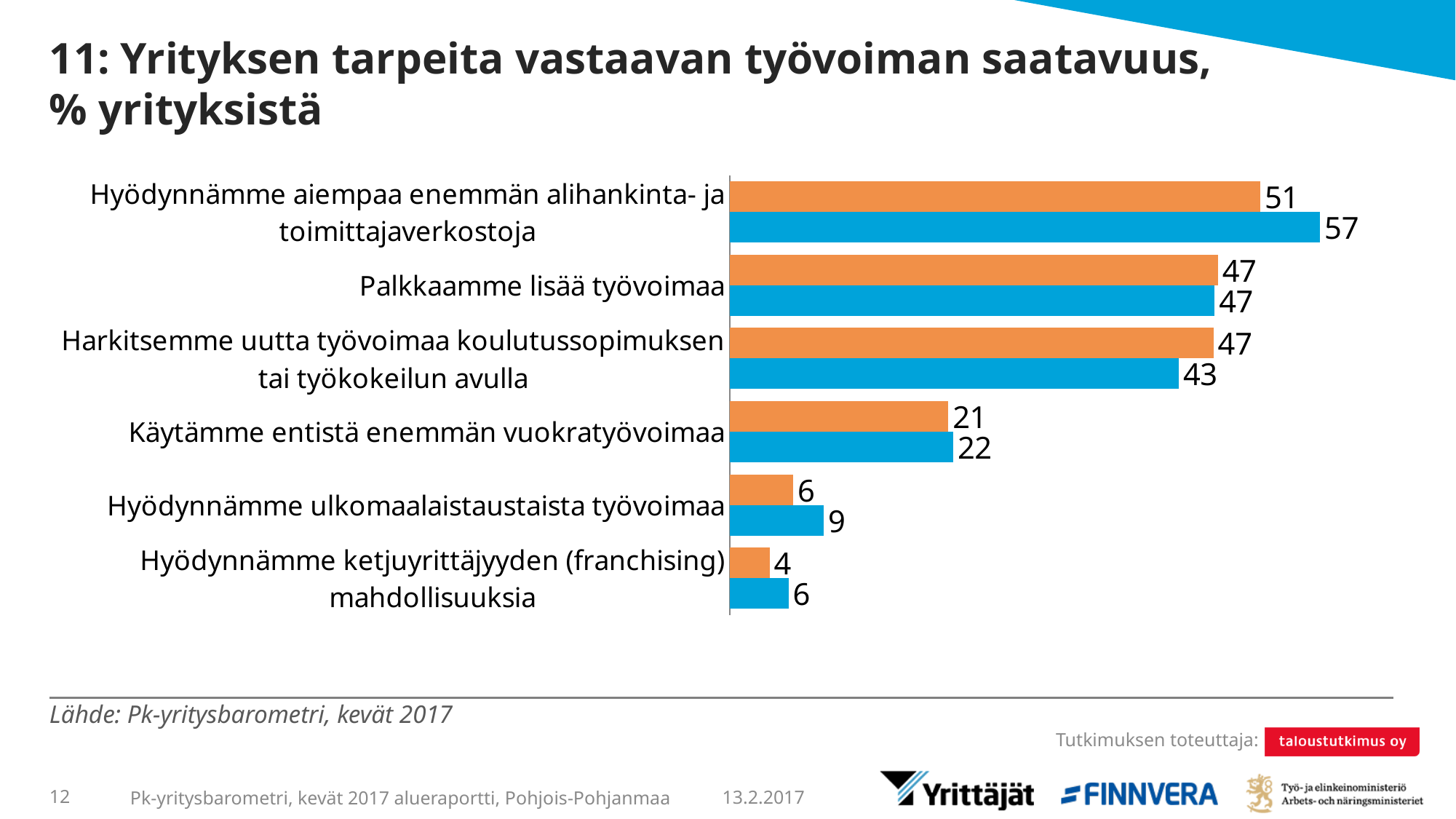
How many categories are shown in the chart? 6 Which category has the highest blue bar value? Hyödynnämme aiempaa enemmän alihankinta- ja toimittajaverkostoja What is the value of the blue bar for "Hyödynnämme ulkomaalaistaustaista työvoimaa"? 9 What is the value of the orange bar for "Palkkaamme lisää työvoimaa"? 47 What is the difference between the blue and orange bar values for "Hyödynnämme aiempaa enemmän alihankinta- ja toimittajaverkostoja"? 6 What is the value of the blue bar for "Hyödynnämme aiempaa enemmän alihankinta- ja toimittajaverkostoja"? 57 What is the source cited below the chart? Pk-yritysbarometri, kevät 2017 Which category has the lowest orange bar value? Hyödynnämme ketjuyrittäjyyden (franchising) mahdollisuuksia What is the difference between the orange and blue bar values for "Harkitsemme uutta työvoimaa koulutussopimuksen tai työkokeilun avulla"? 4 What type of chart is shown on the slide? bar chart What is the value of the orange bar for "Käytämme entistä enemmän vuokratyövoimaa"? 21 For "Hyödynnämme ketjuyrittäjyyden (franchising) mahdollisuuksia", which bar is larger, orange or blue? blue